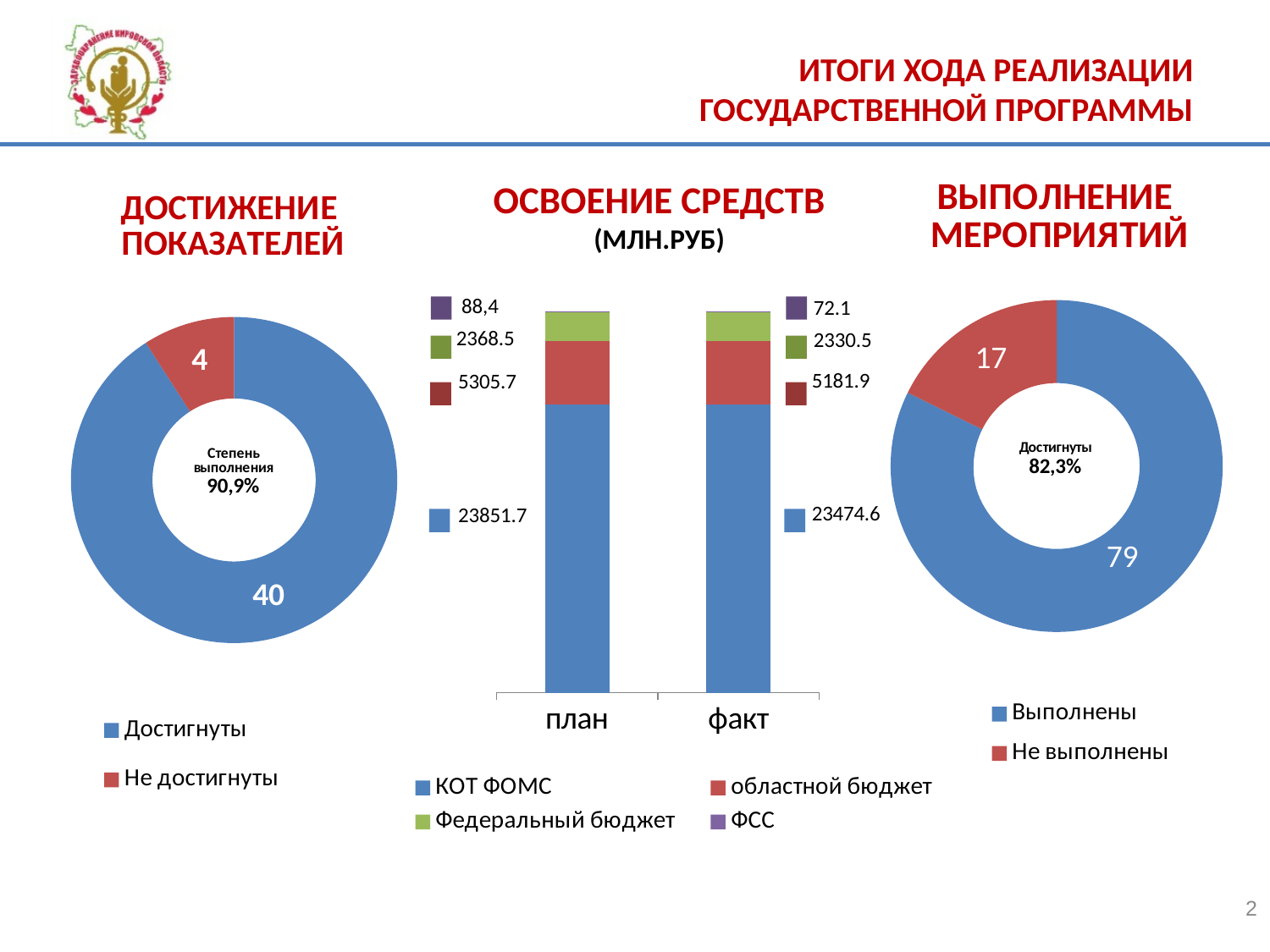
In the chart titled ОСВОЕНИЕ СРЕДСТВ (МЛН.РУБ), what kind of chart is it? Stacked bar chart In the chart titled ОСВОЕНИЕ СРЕДСТВ (МЛН.РУБ), which series is the largest in the факт bar? КОТ ФОМС In the chart titled ДОСТИЖЕНИЕ ПОКАЗАТЕЛЕЙ, what is the value for Достигнуты? 40 In the chart titled ВЫПОЛНЕНИЕ МЕРОПРИЯТИЙ, which category is larger, Выполнены or Не выполнены? Выполнены In the chart titled ДОСТИЖЕНИЕ ПОКАЗАТЕЛЕЙ, what share of the total is shown in the centre as the degree of fulfilment (Степень выполнения)? 90,9% In the chart titled ОСВОЕНИЕ СРЕДСТВ (МЛН.РУБ), what is the value of ФСС for план? 88,4 In the chart titled ОСВОЕНИЕ СРЕДСТВ (МЛН.РУБ), how many series does the legend list? 4 In the chart titled ДОСТИЖЕНИЕ ПОКАЗАТЕЛЕЙ, what is the value for Не достигнуты? 4 In the chart titled ВЫПОЛНЕНИЕ МЕРОПРИЯТИЙ, what is the value for Не выполнены? 17 In the chart titled ОСВОЕНИЕ СРЕДСТВ (МЛН.РУБ), what is the value of КОТ ФОМС for план? 23851.7 In the chart titled ОСВОЕНИЕ СРЕДСТВ (МЛН.РУБ), what is the value of областной бюджет for факт? 5181.9 In the chart titled ОСВОЕНИЕ СРЕДСТВ (МЛН.РУБ), what is the difference between the КОТ ФОМС values for план and факт? 377.1